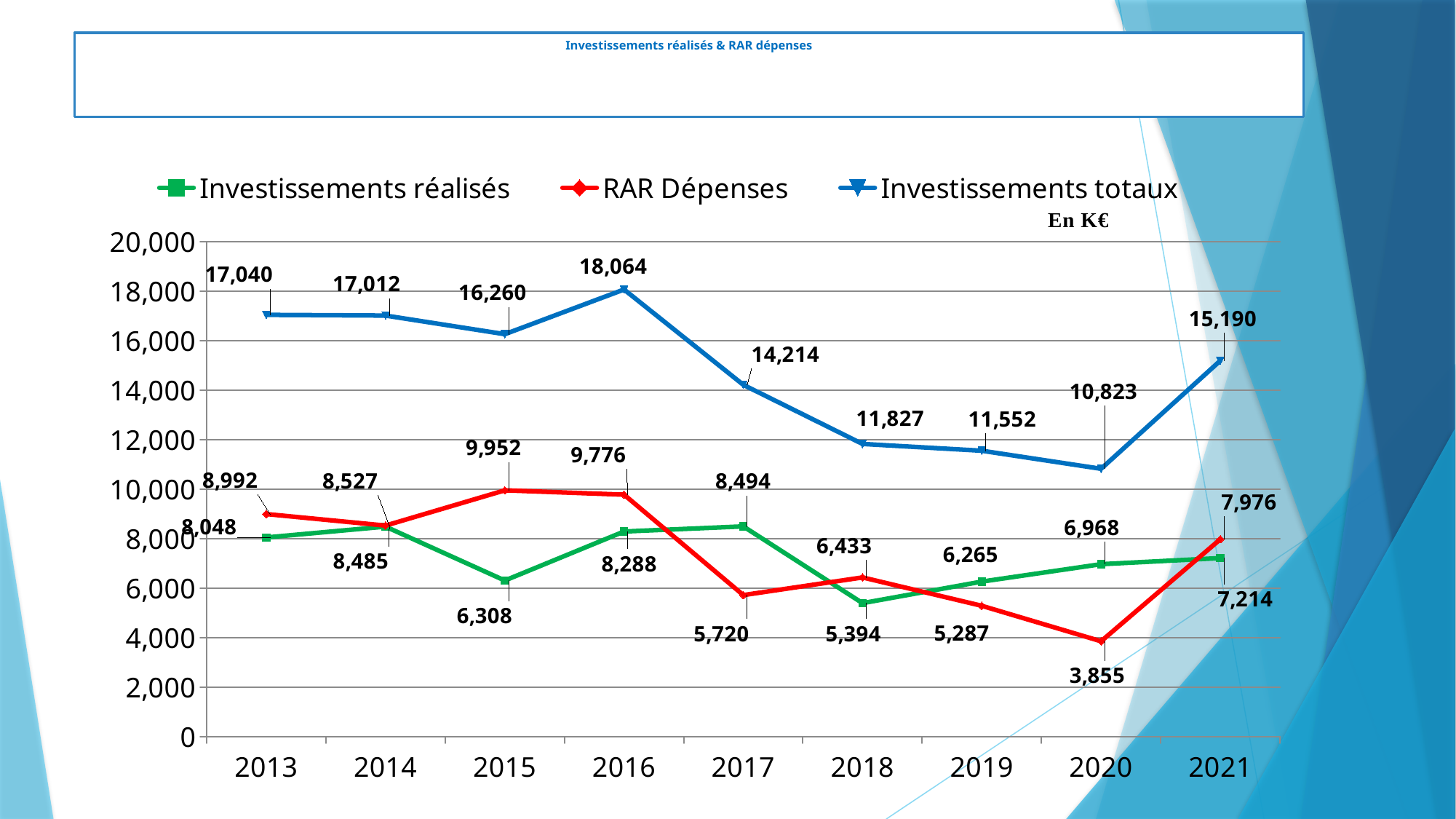
In which year is Investissements réalisés lowest? 2018 What kind of chart is shown on the slide? Line chart How many series does the legend list? 3 Which is larger in 2015: Investissements réalisés or RAR Dépenses? RAR Dépenses What is the value of Investissements réalisés in 2017? 8,494 In which year is RAR Dépenses lowest? 2020 What is the value of RAR Dépenses in 2020? 3,855 What is the value of Investissements totaux in 2016? 18,064 What is the difference between Investissements totaux in 2016 and in 2020? 7,241 How many years are shown on the x axis? 9 In which year is Investissements totaux highest? 2016 What unit is indicated for the values on the chart? En K€